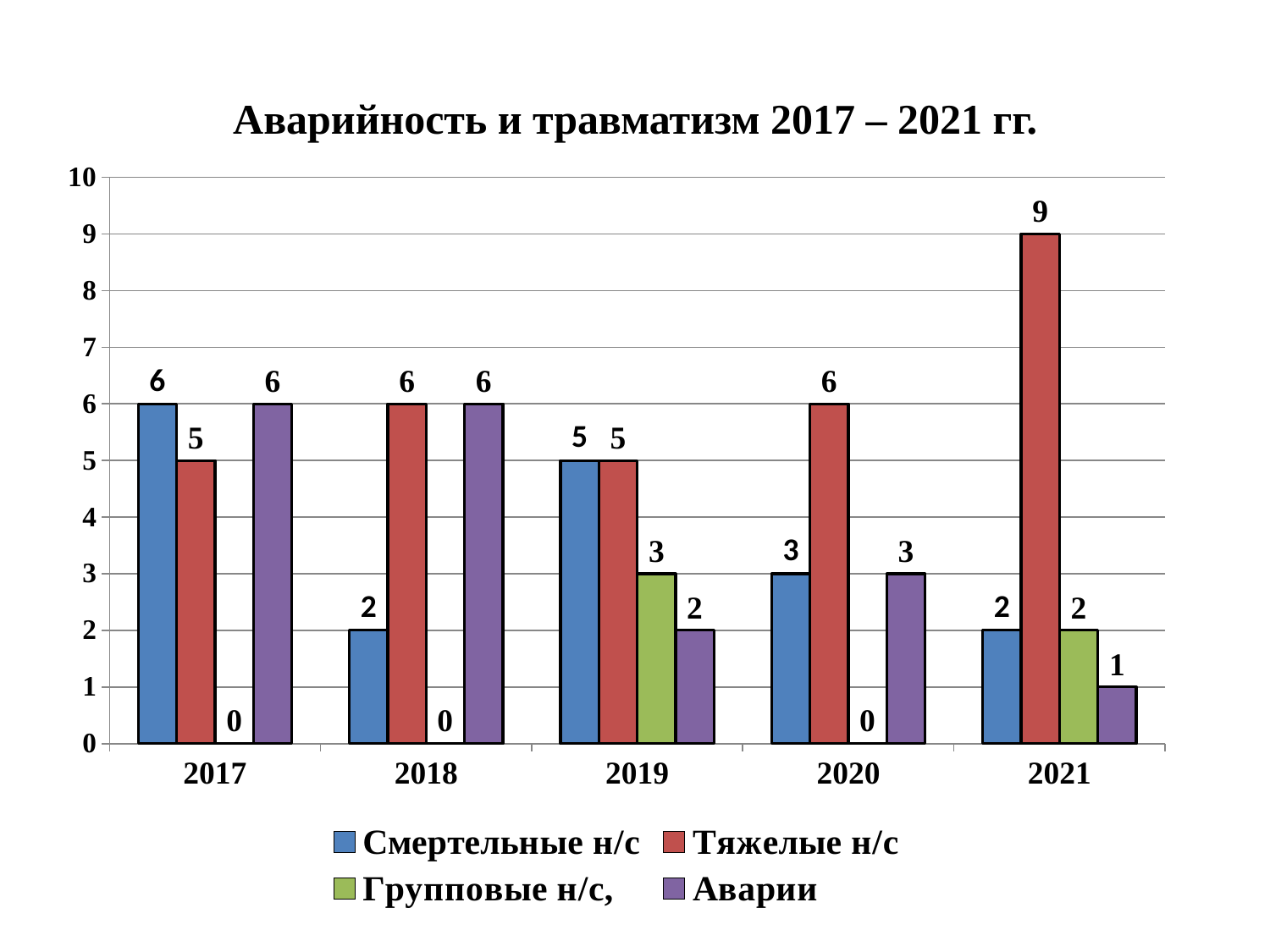
What is the value for Групповые н/с in 2019? 3 How many series does the legend list? 4 What is the value for Смертельные н/с in 2018? 2 In which year is the value for Аварии lowest? 2021 In which year is the value for Тяжелые н/с highest? 2021 What is the difference between Тяжелые н/с and Смертельные н/с in 2021? 7 What is the title of the chart? Аварийность и травматизм 2017 – 2021 гг. Which is larger in 2020: Смертельные н/с or Тяжелые н/с? Тяжелые н/с What kind of chart is shown on the slide? bar chart What is the value for Аварии in 2020? 3 What is the value for Тяжелые н/с in 2021? 9 How many years are shown on the x axis? 5